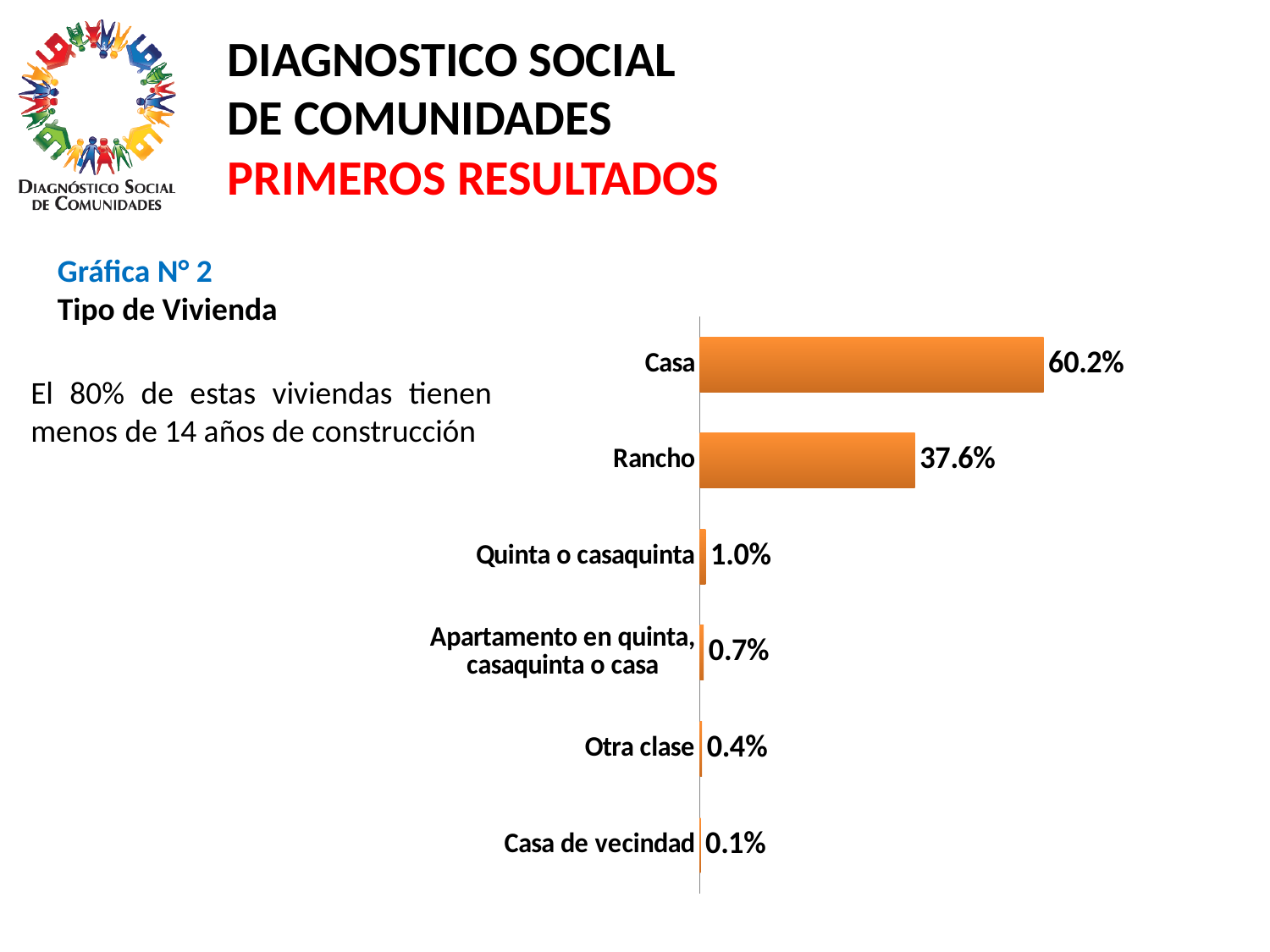
What colour are the bars in the chart? Orange Which is larger, the value for Otra clase or the value for Apartamento en quinta, casaquinta o casa? Apartamento en quinta, casaquinta o casa What is the value for Quinta o casaquinta? 1.0% What is the value for Casa? 60.2% Which category has the lowest value? Casa de vecindad What is the difference between the values for Casa and Rancho? 22.6% What is the value for Rancho? 37.6% Which category has the highest value? Casa What is the title of the chart? Gráfica N° 2 Tipo de Vivienda What kind of chart is shown on the slide? Bar chart What is the value for Casa de vecindad? 0.1% How many categories are shown in the chart? 6